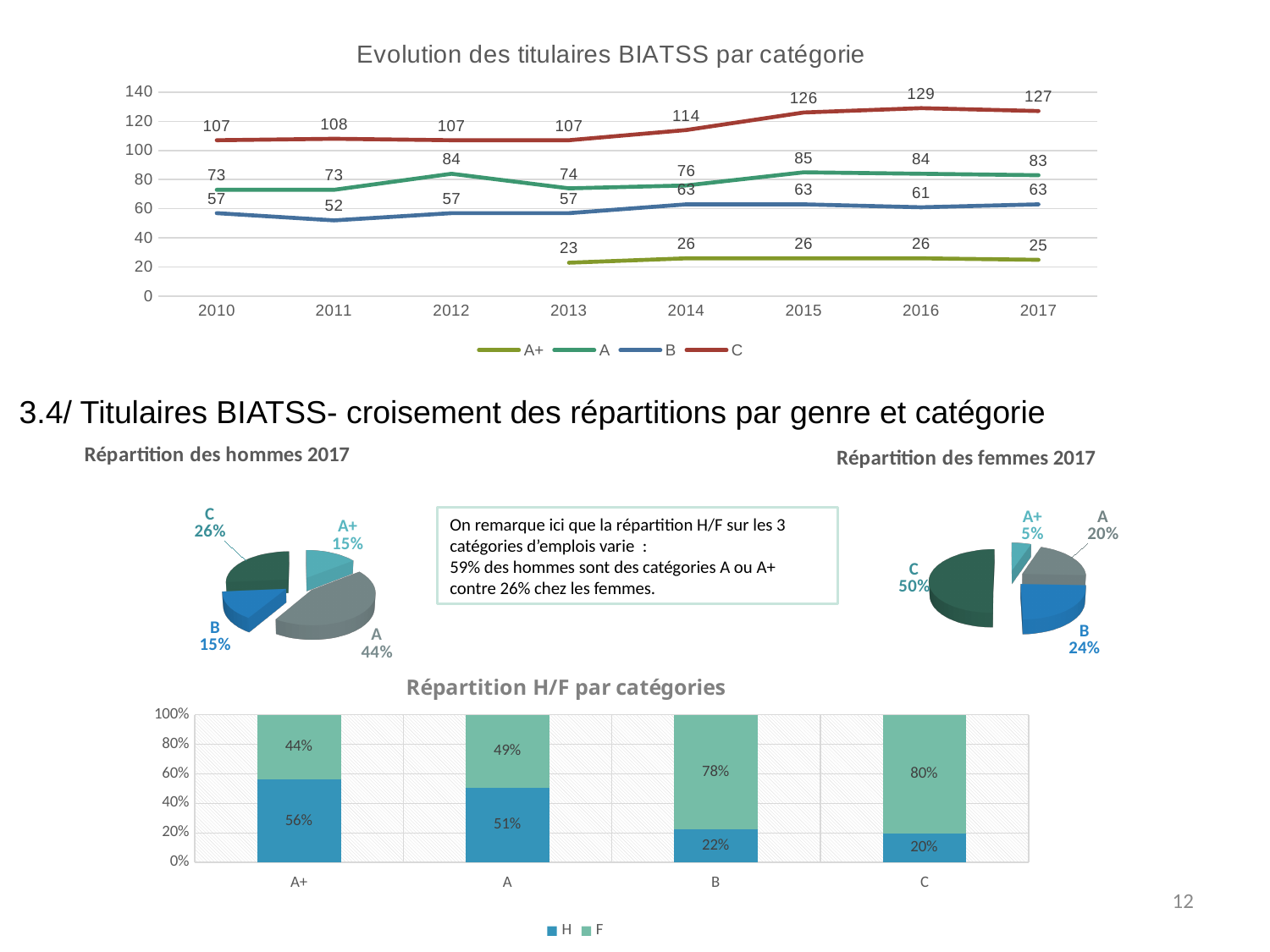
In the pie chart 'Répartition des femmes 2017', which category has the smallest slice? A+ In the pie chart 'Répartition des femmes 2017', what share does category C have? 50% In the stacked bar chart 'Répartition H/F par catégories', what is the value of H for category A+? 56% In the line chart 'Evolution des titulaires BIATSS par catégorie', in which year is series B at its lowest? 2011 How many series does the legend of the line chart 'Evolution des titulaires BIATSS par catégorie' list? 4 In the pie chart 'Répartition des hommes 2017', what share does category A have? 44% How many years are shown on the x axis of the line chart 'Evolution des titulaires BIATSS par catégorie'? 8 In the line chart 'Evolution des titulaires BIATSS par catégorie', what is the value for series C in 2016? 129 In the line chart 'Evolution des titulaires BIATSS par catégorie', what is the value for series A in 2012? 84 In the stacked bar chart 'Répartition H/F par catégories', which is larger: the F value for category B or the F value for category C? C In the line chart 'Evolution des titulaires BIATSS par catégorie', what is the difference between the value of series C in 2017 and in 2010? 20 In the line chart 'Evolution des titulaires BIATSS par catégorie', does series C rise or fall between 2013 and 2016? rise